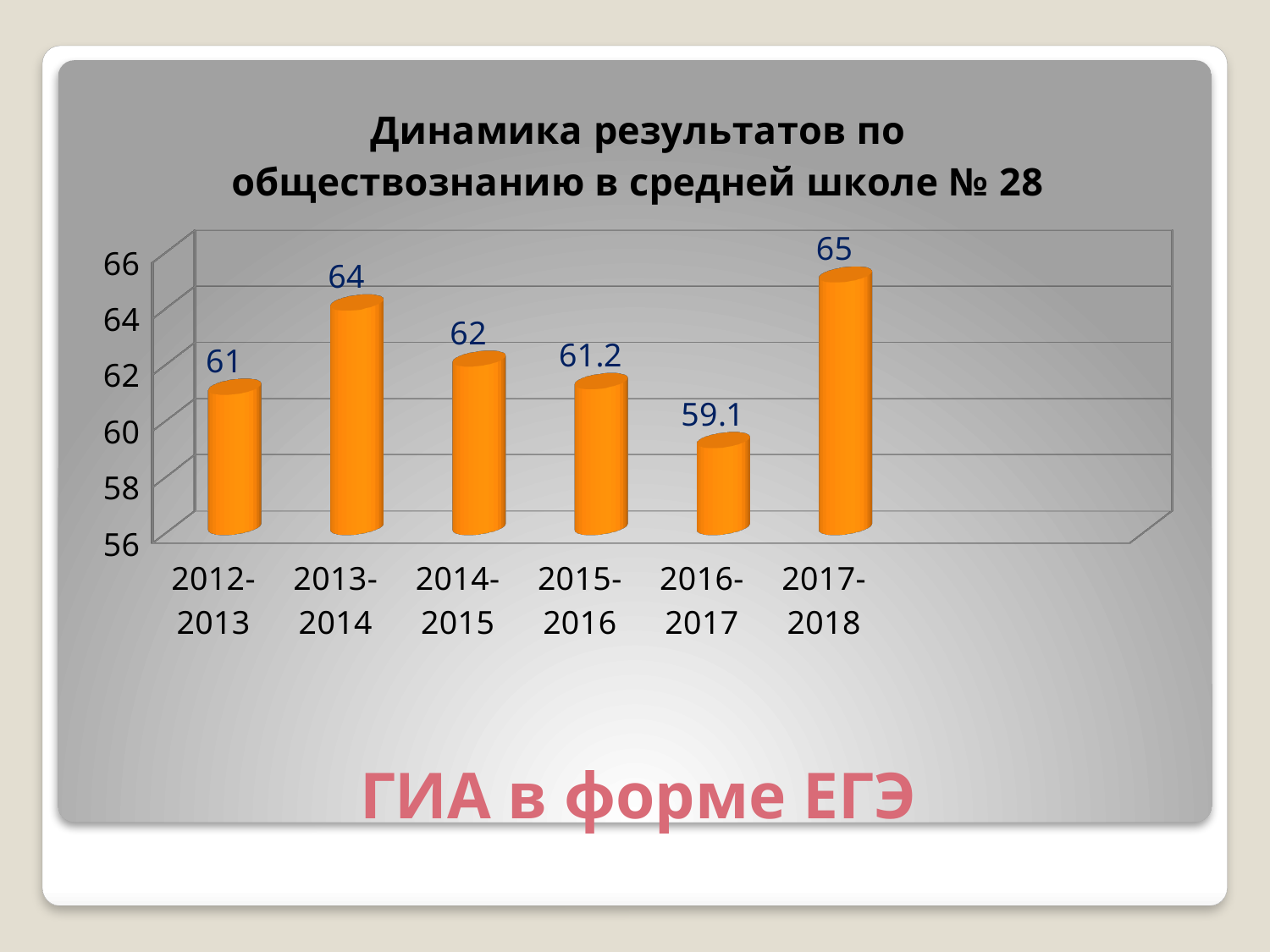
Is the value for 2017-2018 greater or less than 64? greater What kind of chart is shown on the slide? bar chart Which is larger, the value for 2013-2014 or the value for 2015-2016? 2013-2014 What is the difference between the values for 2017-2018 and 2016-2017? 5.9 Which year has the highest value? 2017-2018 What is the title of the chart? Динамика результатов по обществознанию в средней школе № 28 What is the difference between the values for 2013-2014 and 2014-2015? 2 What is the value for 2015-2016? 61.2 How many years are shown on the chart? 6 What is the value for 2012-2013? 61 What is the value for 2016-2017? 59.1 Which year has the lowest value? 2016-2017